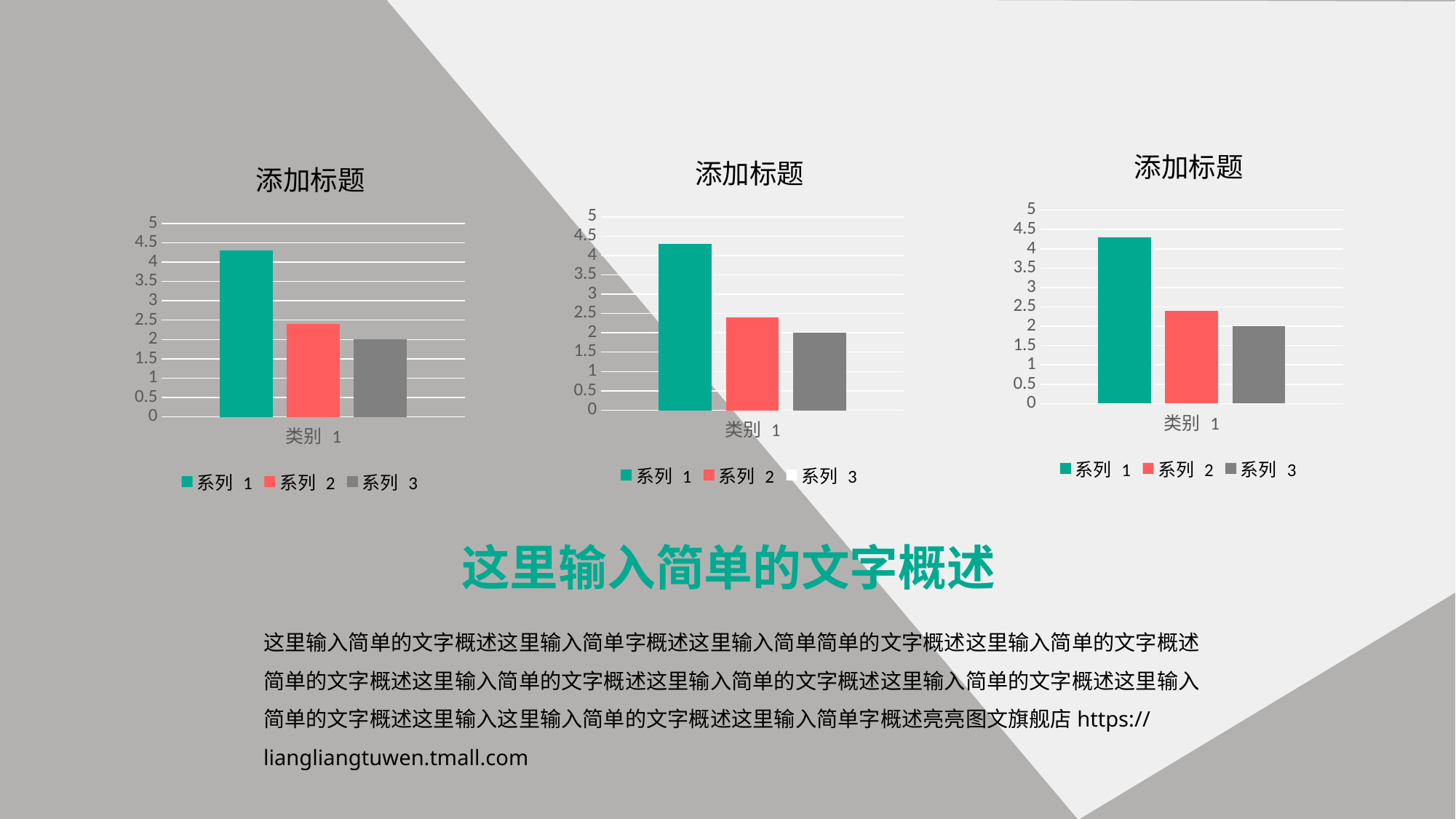
In the right chart, which is larger, the bar for 系列 1 or the bar for 系列 2? 系列 1 How many series does the legend of the middle chart list? 3 In the left chart, which series has the highest bar? 系列 1 What kind of chart is the left chart on the slide? bar chart In the left chart, is the value for 系列 1 greater or less than 4? greater In the right chart, is the value for 系列 2 greater or less than 2? greater What is the title of the right chart? 添加标题 In the middle chart, which series has the lowest bar? 系列 3 What is the category label on the x axis of the middle chart? 类别 1 How many categories are shown on the x axis of the right chart? 1 In the middle chart, is the value for 系列 2 greater or less than 3? less In the left chart, what is the value for 系列 3? 2